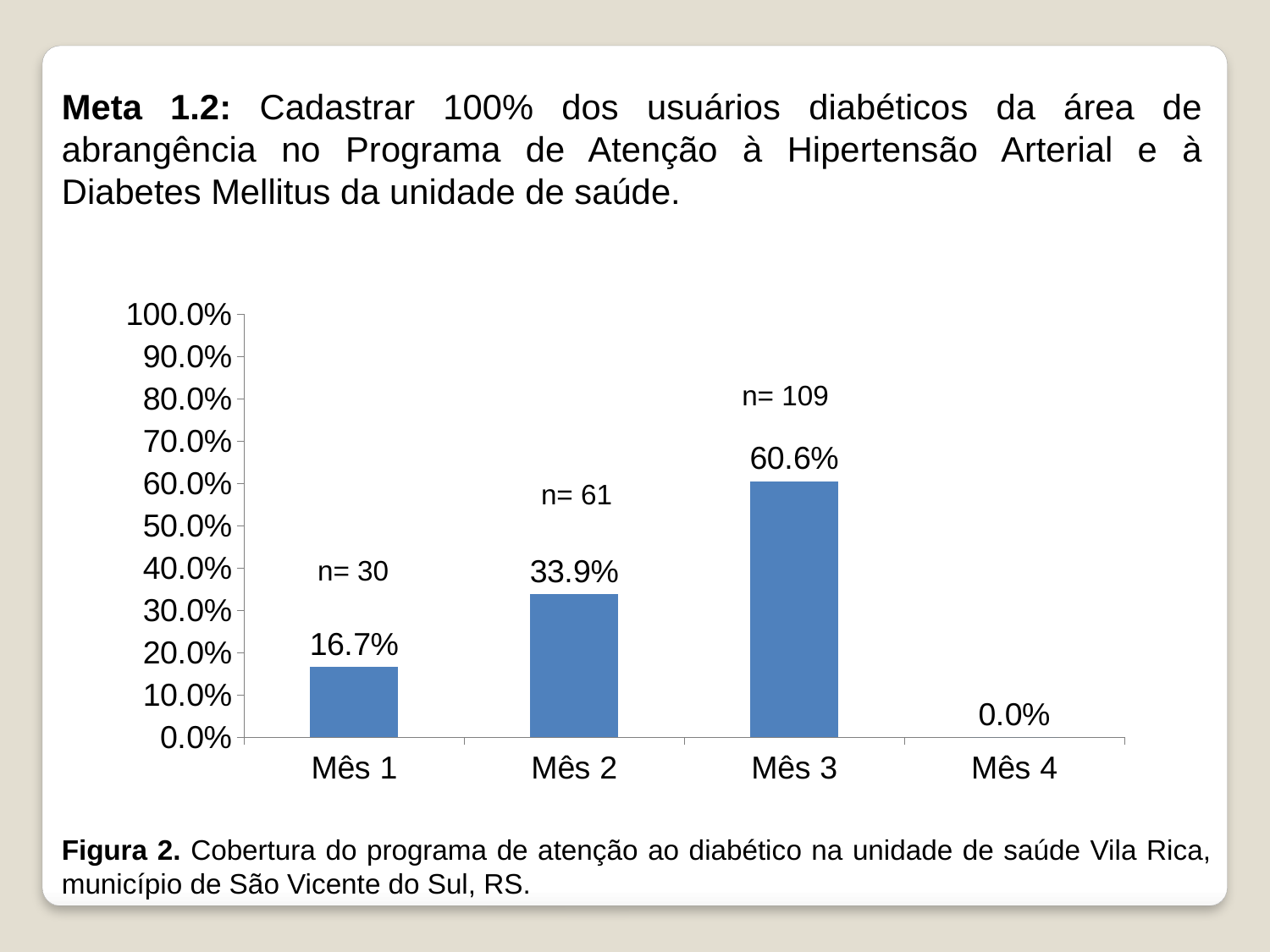
Which is larger, the value for Mês 1 or the value for Mês 2? Mês 2 How many months are shown on the x axis? 4 Is the value for Mês 3 greater or less than 50.0%? greater Which month has the highest value? Mês 3 What is the value for Mês 3? 60.6% What is the value for Mês 1? 16.7% What is the value for Mês 2? 33.9% Which month has the lowest value? Mês 4 What is the difference between the values for Mês 3 and Mês 2? 26.7% What is the value for Mês 4? 0.0% What kind of chart is shown? bar chart What is the n value annotated above the bar for Mês 3? n= 109